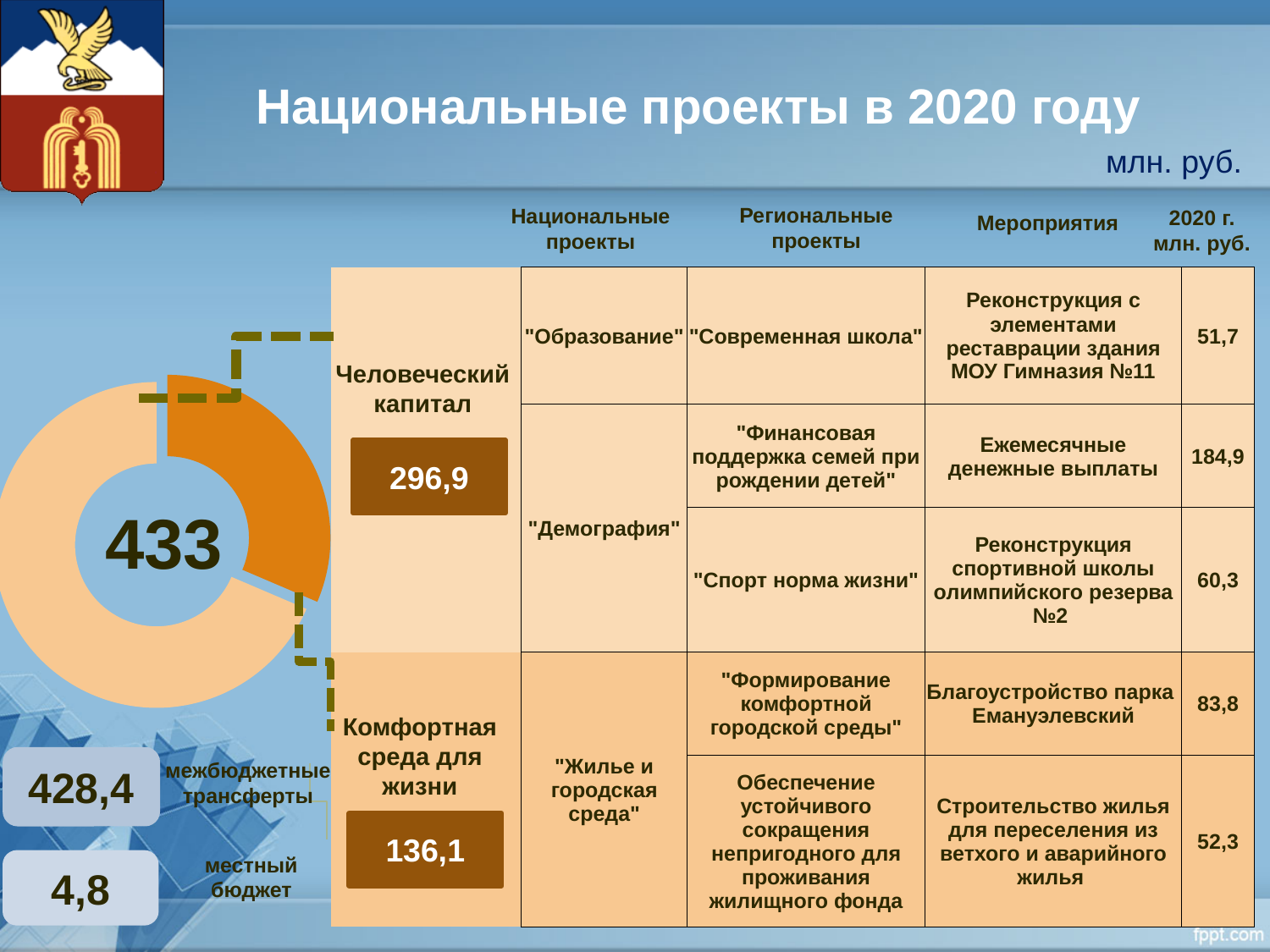
Which segment of the donut chart is the largest? Человеческий капитал What is the value shown for Человеческий капитал in the donut chart? 296,9 In what units are the values on the slide given? млн. руб. What is the value shown for Комфортная среда для жизни in the donut chart? 136,1 How many segments does the donut chart have? 2 What is the title of the slide containing the donut chart? Национальные проекты в 2020 году Which segment of the donut chart is the smallest? Комфортная среда для жизни Which is larger: Человеческий капитал or Комфортная среда для жизни? Человеческий капитал What kind of chart is shown on the left of the slide? pie (donut) chart Is the value for Комфортная среда для жизни greater or less than 150? less What is the difference between the values for Человеческий капитал and Комфортная среда для жизни? 160,8 What total is shown in the centre of the donut chart? 433